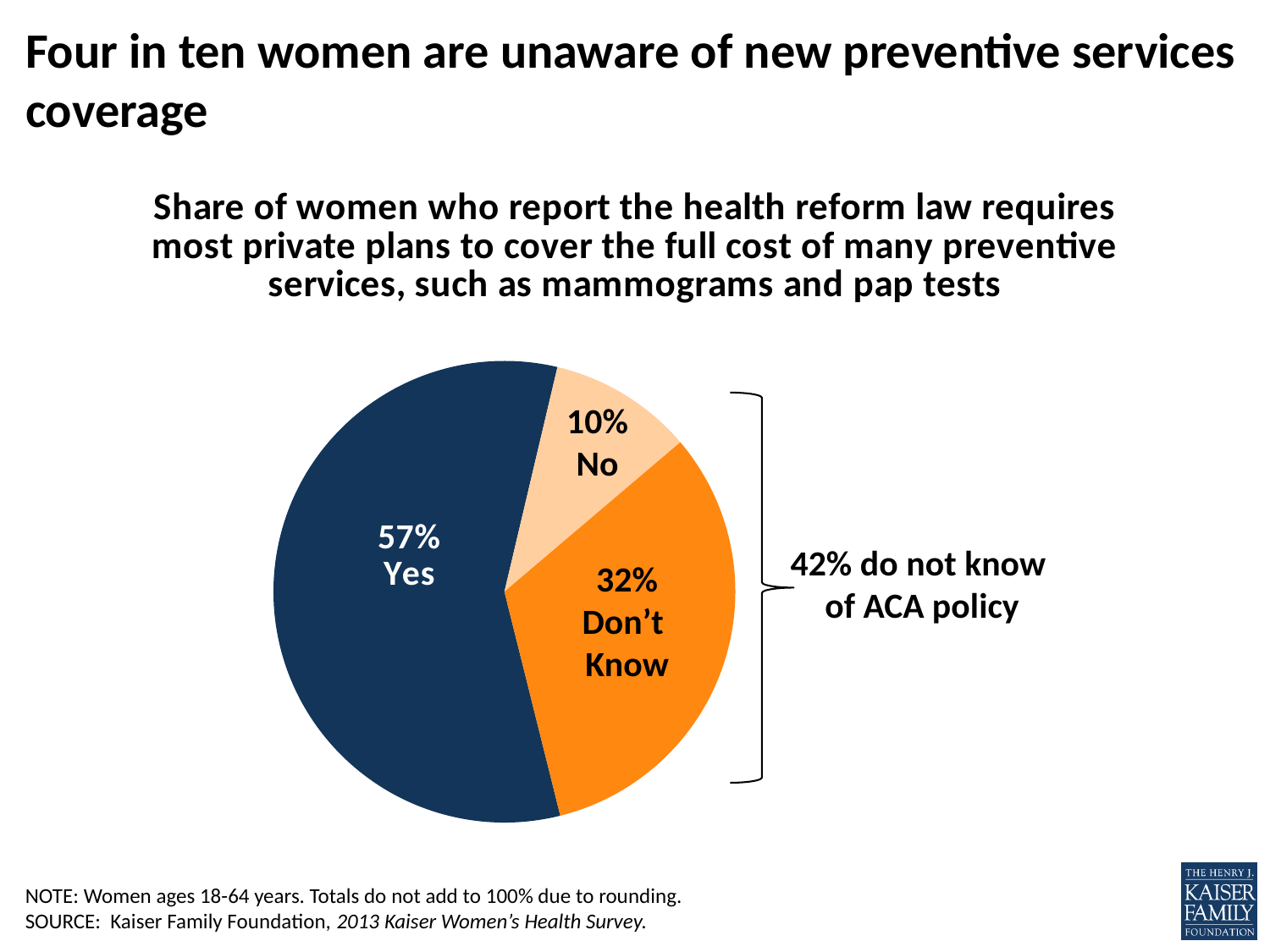
What colour is the "Yes" slice of the pie? Dark blue What kind of chart is shown on the slide? Pie chart What is the difference in percentage points between the "Don't Know" and "No" slices? 22 According to the bracket annotation, what share of women do not know of the ACA policy? 42% What share of women answered "No"? 10% Which response has the largest slice of the pie? Yes Which is larger, the "Don't Know" slice or the "No" slice? Don't Know What share of women answered "Yes"? 57% What is the difference in percentage points between the "Yes" and "Don't Know" slices? 25 What share of women answered "Don't Know"? 32% Which response has the smallest slice of the pie? No How many slices does the pie chart have? 3